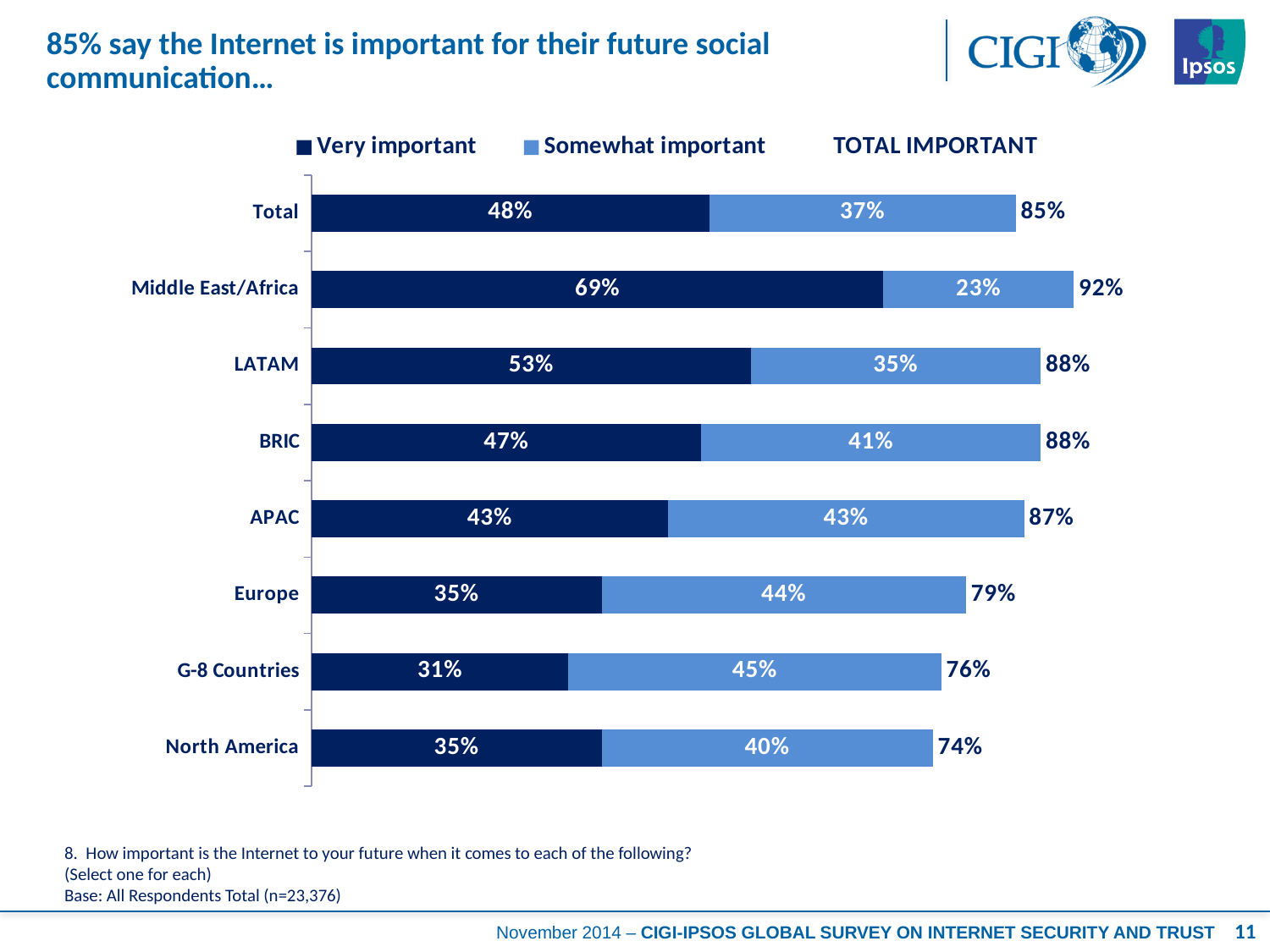
What kind of chart is shown on the slide? Stacked bar chart What is the TOTAL IMPORTANT value for North America? 74% What is the 'Somewhat important' value for G-8 Countries? 45% What is the 'Very important' value for Middle East/Africa? 69% What is the total of the stacked bar for Europe? 79% What is the difference between the 'Very important' values for Middle East/Africa and G-8 Countries? 38% Which series is shown in the darker blue colour? Very important Which is larger, the 'Somewhat important' value for BRIC or for LATAM? BRIC How many categories are shown on the chart? 8 How many series does the legend list? 3 Which category has the highest 'Very important' value? Middle East/Africa Which category has the lowest TOTAL IMPORTANT value? North America